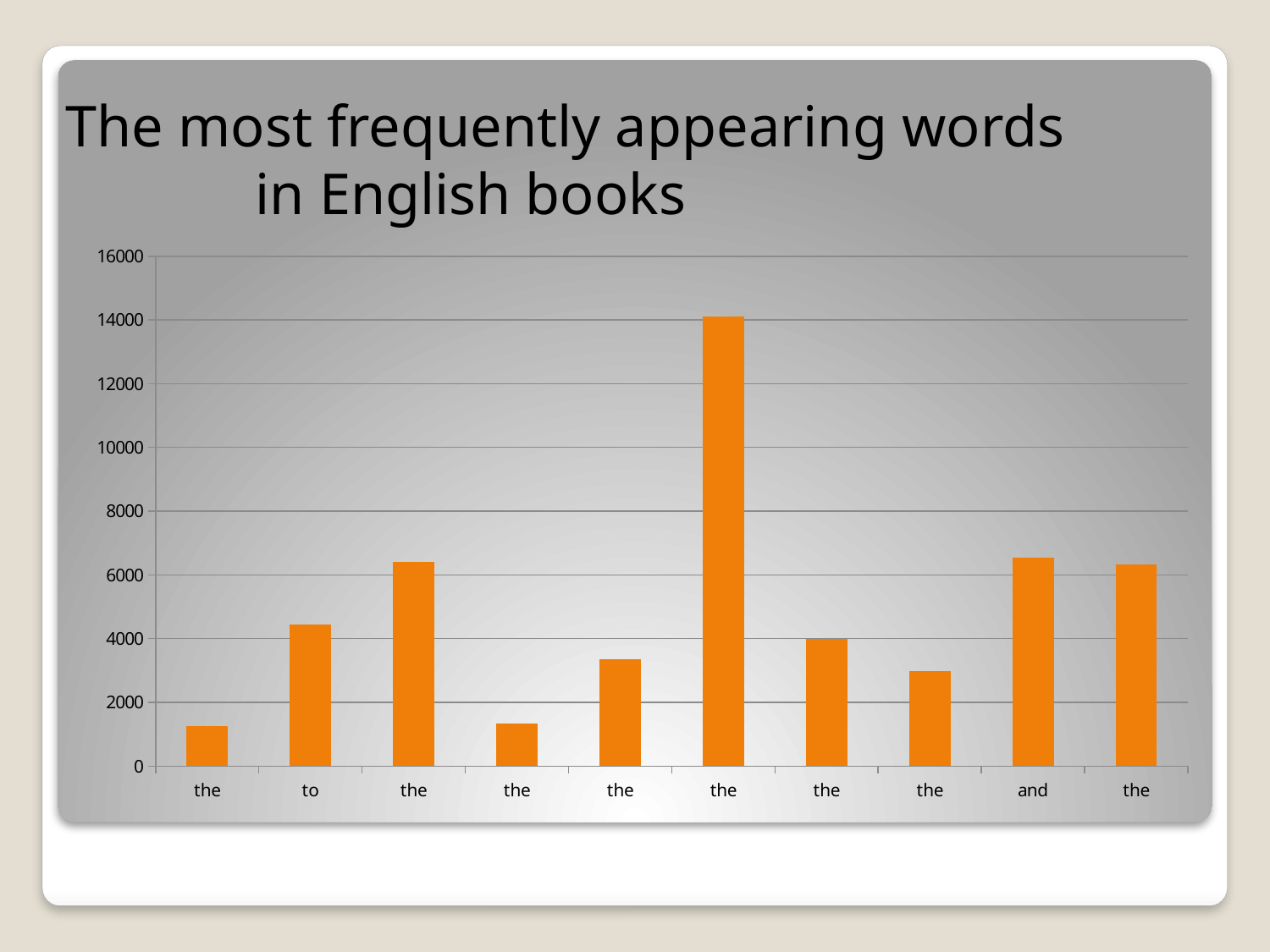
Which bar is the tallest in the chart? the sixth bar from the left (labelled "the") Which is larger, the value for "to" or the value of the sixth bar from the left? the sixth bar from the left How many bars are plotted in the chart? 10 Is the value of the fifth bar from the left greater or less than 4000? less Is the value of the tallest bar greater or less than 12000? greater Is the value of the first bar from the left greater or less than 2000? less What colour are the bars in the chart? orange What kind of chart is shown on the slide? bar chart What is the title of the slide? The most frequently appearing words in English books Which has the larger value, "and" or "to"? and